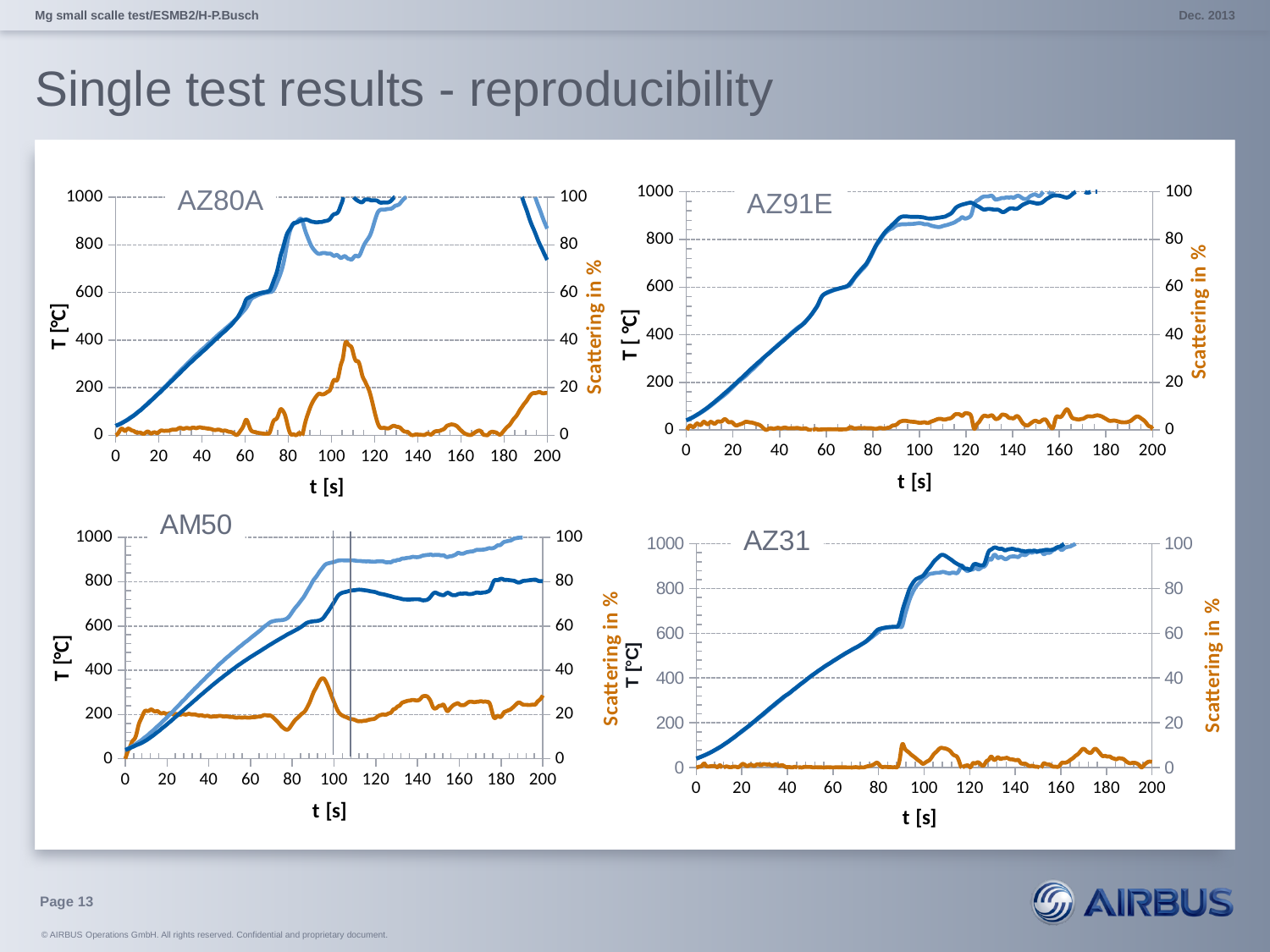
In the AZ31 chart, is the temperature at t = 60 s greater or less than 400? greater In the AZ91E chart, does the temperature rise or fall as time increases from 0 to 100 s? rise How many lines are plotted in the AZ91E chart? 3 What is the x-axis label of the AZ91E chart? t [s] In the AZ31 chart, is the scattering value at t = 60 s greater or less than 20? less What is the label of the right-hand vertical axis on the AM50 chart? Scattering in % In the AM50 chart, is the peak scattering value near t = 95 s greater or less than 20? greater How many charts are shown on the slide? 4 What kind of chart is the AZ80A chart? line chart